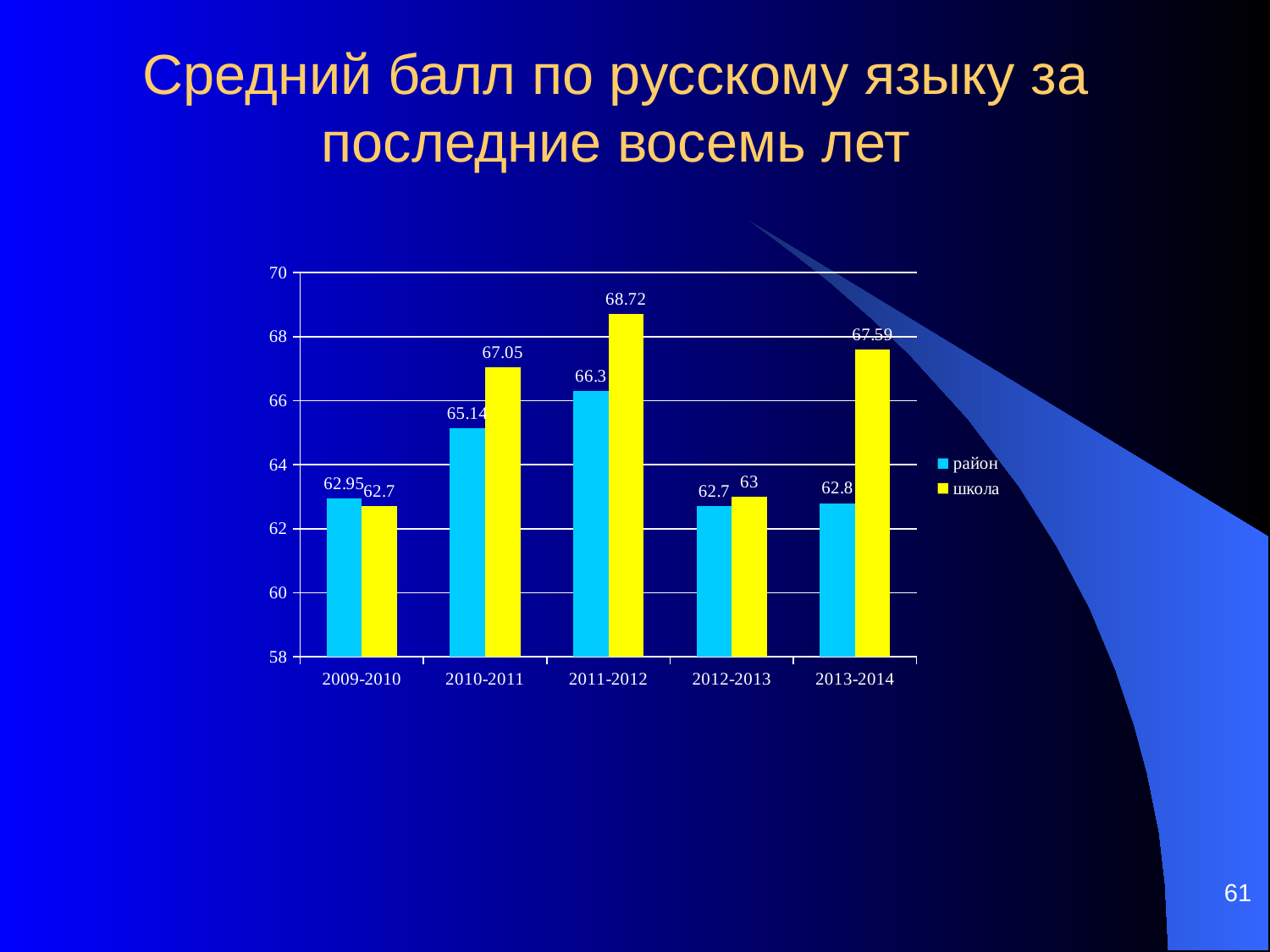
How many series does the legend list? 2 What is the difference between the школа and район values in 2013-2014? 4.79 How many year categories are shown on the x axis? 5 What kind of chart is shown on the slide? bar chart What is the value for школа in 2013-2014? 67.59 In which year is the школа value highest? 2011-2012 What is the value for район in 2012-2013? 62.7 In which year is the район value lowest? 2012-2013 What is the value for район in 2010-2011? 65.14 What is the value for школа in 2011-2012? 68.72 Which is larger in 2009-2010, район or школа? район Which colour represents the школа series? yellow